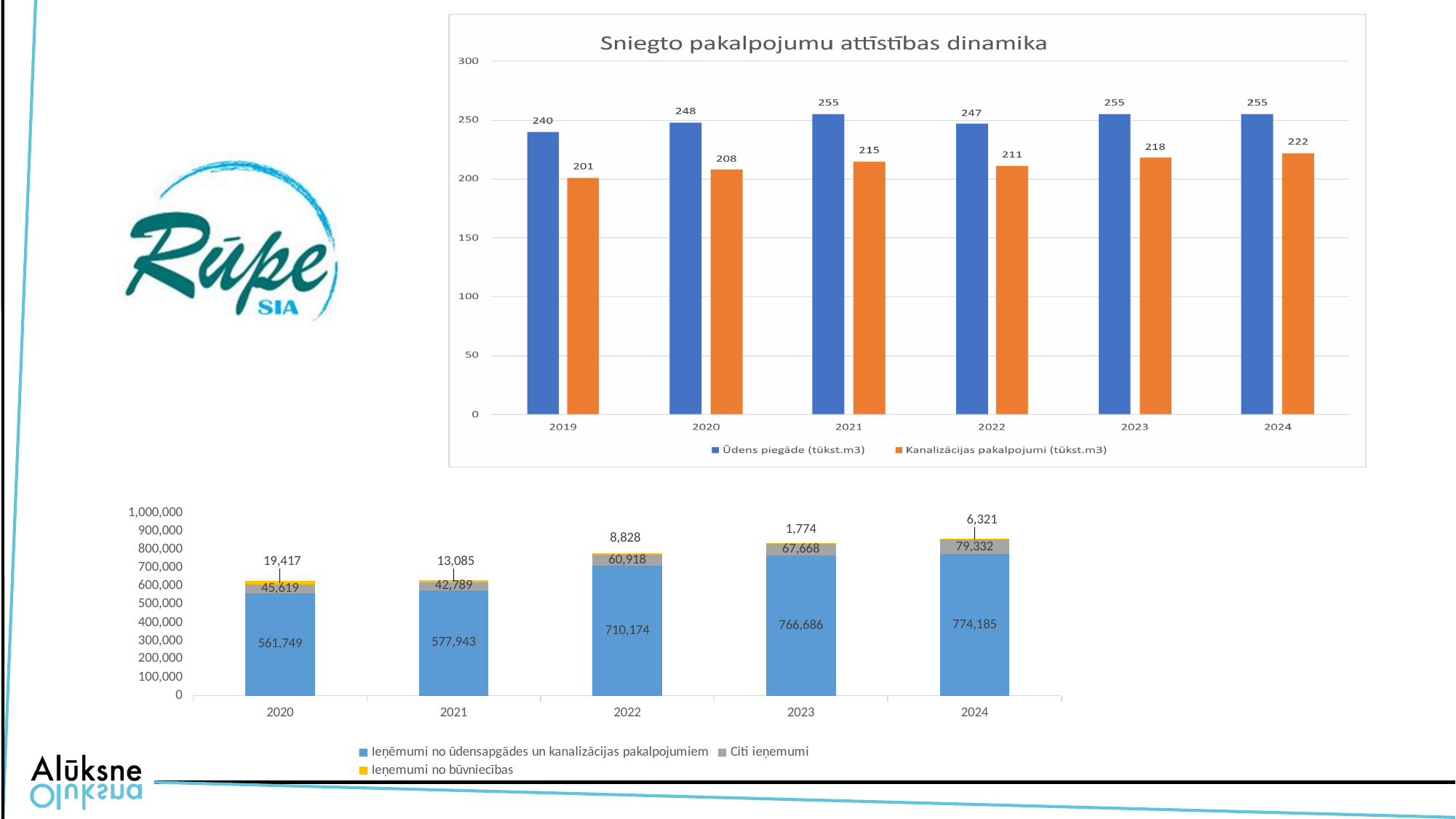
In the bottom chart, which year has the highest value for Citi ieņemumi? 2024 In the bottom chart, what is the total of the stacked bar for 2024? 859,838 In the chart titled 'Sniegto pakalpojumu attīstības dinamika', what is the value for Kanalizācijas pakalpojumi (tūkst.m3) in 2022? 211 In the bottom chart, what is the value for Ieņēmumi no ūdensapgādes un kanalizācijas pakalpojumiem in 2022? 710,174 In the chart titled 'Sniegto pakalpojumu attīstības dinamika', which year has the highest value for Kanalizācijas pakalpojumi (tūkst.m3)? 2024 In the chart titled 'Sniegto pakalpojumu attīstības dinamika', how many series does the legend list? 2 What kind of chart is the bottom chart? Stacked bar chart In the chart titled 'Sniegto pakalpojumu attīstības dinamika', which year has the lowest value for Ūdens piegāde (tūkst.m3)? 2019 In the chart titled 'Sniegto pakalpojumu attīstības dinamika', what is the difference between Ūdens piegāde and Kanalizācijas pakalpojumi in 2021? 40 In the chart titled 'Sniegto pakalpojumu attīstības dinamika', what is the value for Ūdens piegāde (tūkst.m3) in 2019? 240 In the bottom chart, what is the value for Ieņemumi no būvniecības in 2023? 1,774 In the chart titled 'Sniegto pakalpojumu attīstības dinamika', how many years are shown on the x axis? 6